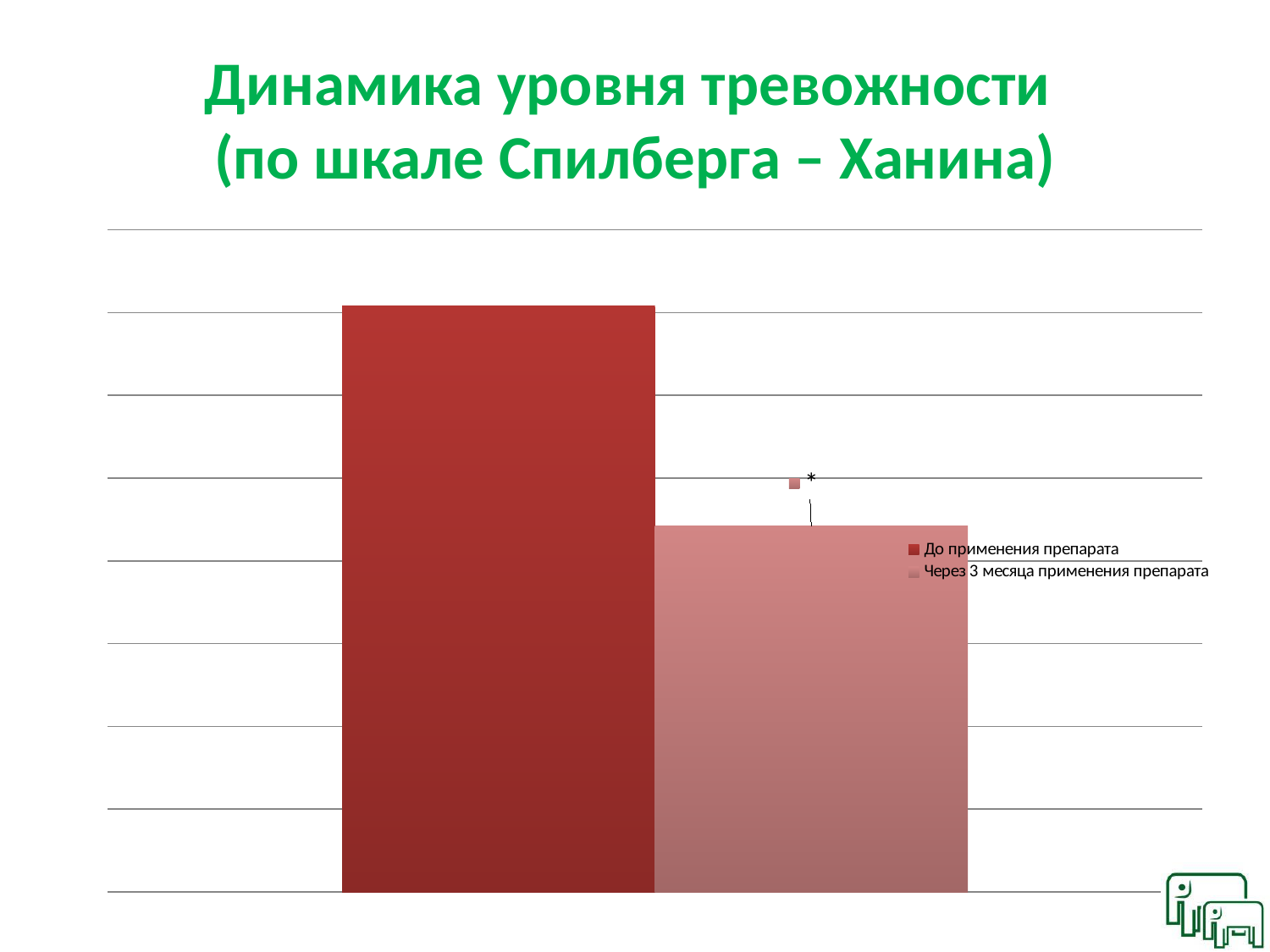
Which series has the taller bar, "До применения препарата" or "Через 3 месяца применения препарата"? До применения препарата How many series does the legend list? 2 Which series has the lowest bar in the chart? Через 3 месяца применения препарата Which series has the highest bar in the chart? До применения препарата What is the title of the slide containing the chart? Динамика уровня тревожности (по шкале Спилберга – Ханина) What is the first entry listed in the chart legend? До применения препарата What kind of chart is shown on the slide? bar chart How many bars are plotted in the chart? 2 Does the anxiety level rise or fall from "До применения препарата" to "Через 3 месяца применения препарата"? fall